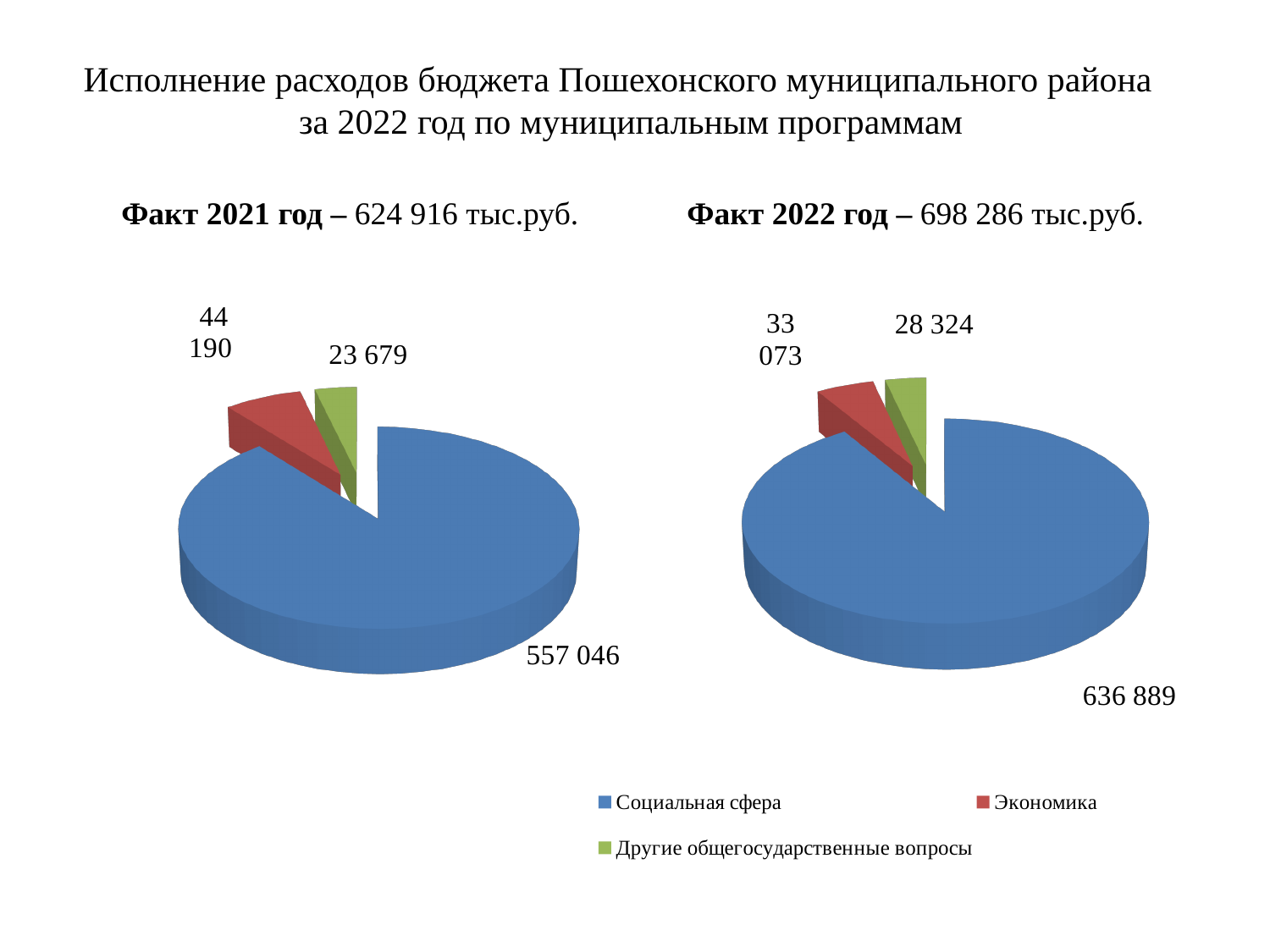
In the Факт 2022 год chart, what is the value for Социальная сфера? 636 889 How many entries does the legend list? 3 Which colour represents Экономика in the pie charts? Red In the Факт 2022 год chart, what is the value for Другие общегосударственные вопросы? 28 324 In the Факт 2021 год chart, what is the value for Социальная сфера? 557 046 What is the difference between the Социальная сфера value in the Факт 2022 год chart and the Социальная сфера value in the Факт 2021 год chart? 79 843 Which is larger: Экономика in the Факт 2021 год chart or Экономика in the Факт 2022 год chart? Факт 2021 год (44 190) In the Факт 2021 год chart, which category has the largest slice? Социальная сфера In the Факт 2022 год chart, which category has the smallest slice? Другие общегосударственные вопросы In the Факт 2021 год chart, what is the value for Экономика? 44 190 What kind of chart is shown for Факт 2021 год? Pie chart How many slices does the Факт 2022 год pie chart have? 3